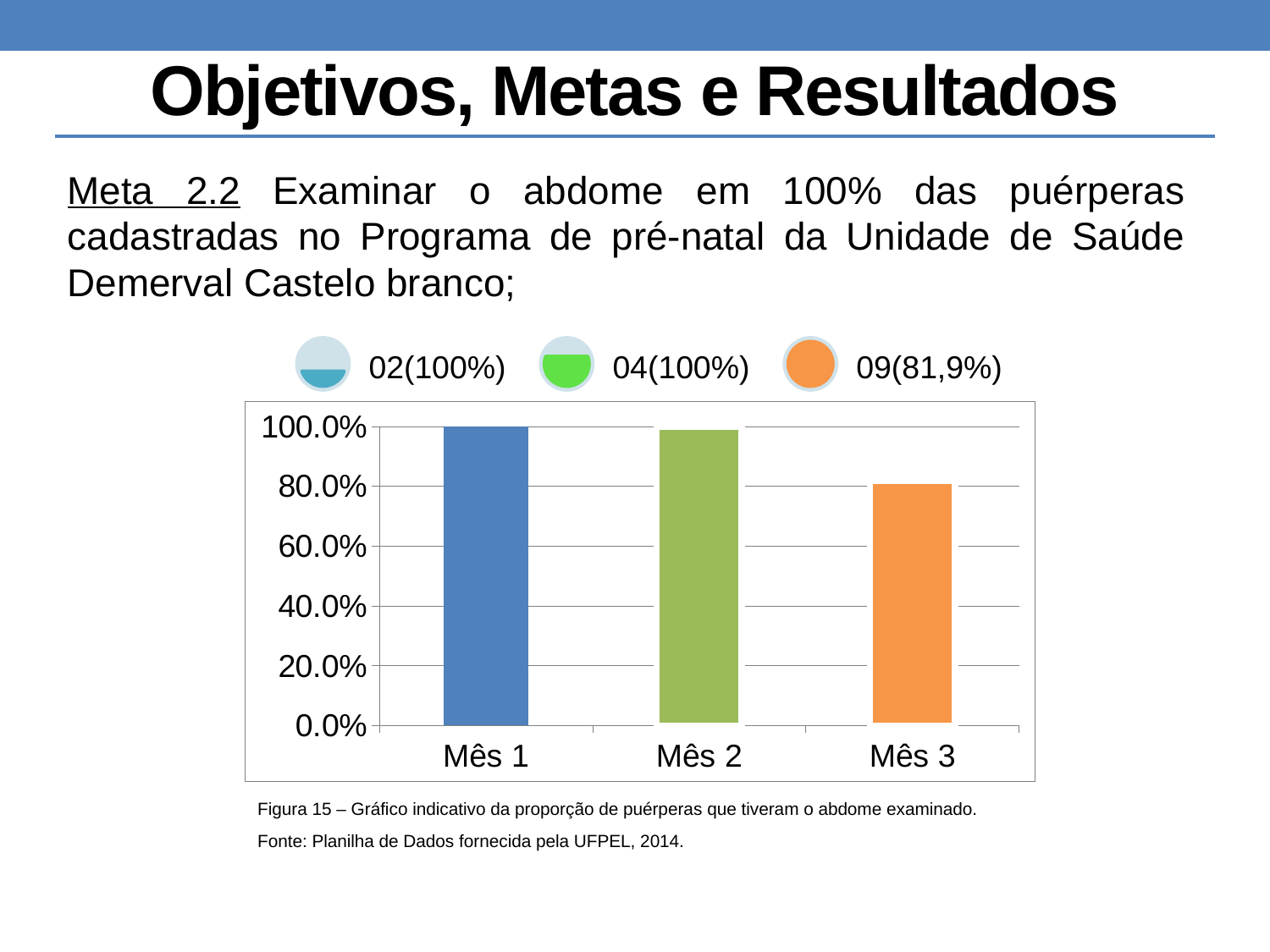
Which is larger, the value for Mês 1 or the value for Mês 3? Mês 1 Is the value for Mês 2 greater or less than 80.0%? greater Do the values rise or fall from Mês 1 to Mês 3? fall What is the value for Mês 1 in the chart? 100% What colour is the bar for Mês 3? orange What is the value for Mês 3 in the chart? 81,9% What kind of chart is shown on the slide? bar chart What is the difference between the value for Mês 1 and the value for Mês 3? 18,1 percentage points Is the value for Mês 3 greater or less than 60.0%? greater How many categories (months) are plotted on the x axis of the chart? 3 Which month has the lowest value in the chart? Mês 3 What is the highest tick label shown on the y axis of the chart? 100.0%